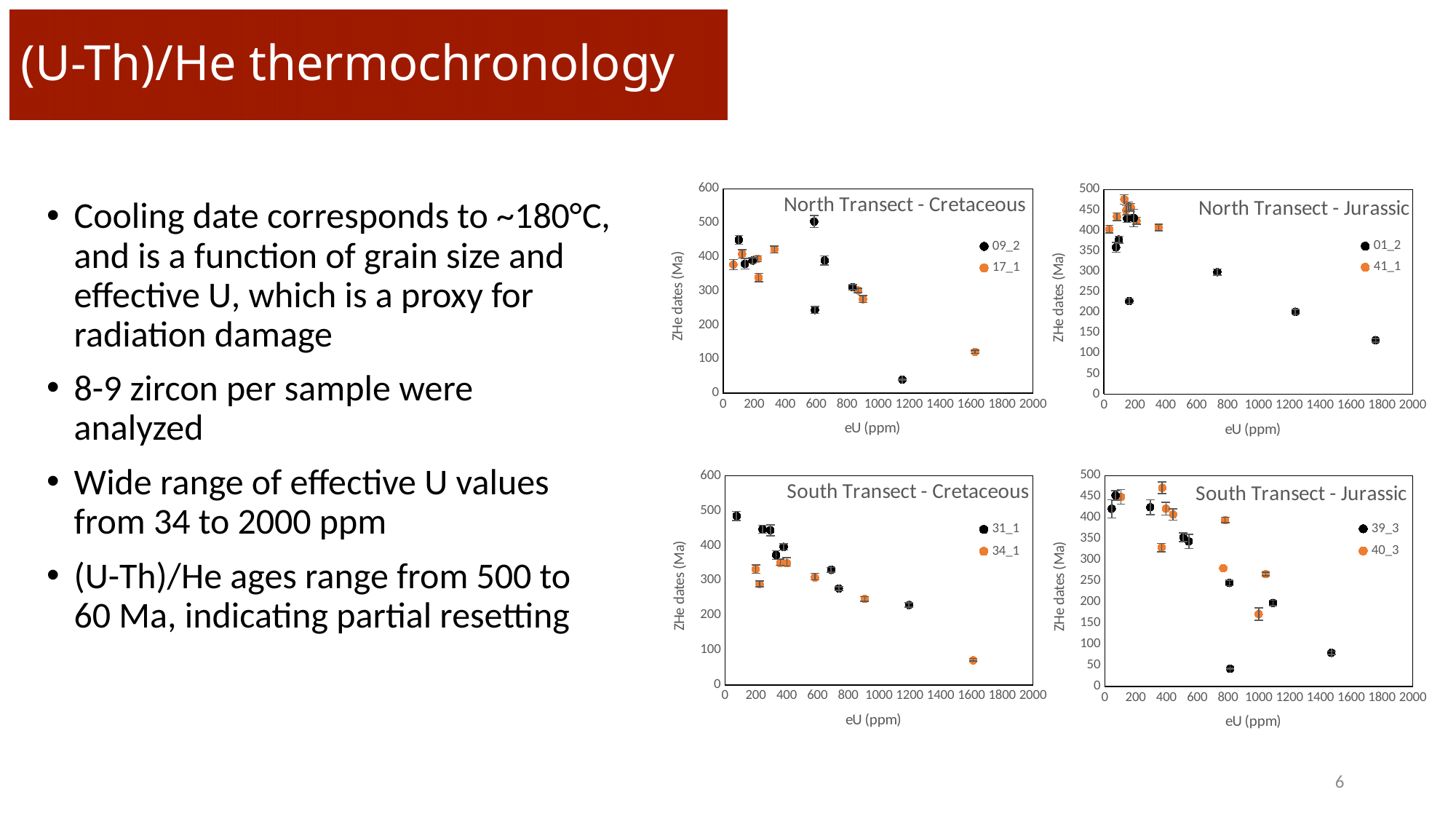
What kind of chart is the "North Transect - Cretaceous" chart? scatter chart In the "South Transect - Cretaceous" chart, do the ZHe dates generally rise or fall as eU increases? fall In the "North Transect - Jurassic" chart, is the ZHe date of the 01_2 point near 1750 ppm eU greater or less than 200? less How many charts are shown on the slide? 4 What are the two legend entries in the "North Transect - Jurassic" chart? 01_2 and 41_1 In the "North Transect - Cretaceous" chart, is the ZHe date of the 17_1 point near 1600 ppm eU greater or less than 200? less What is the x-axis title of the "South Transect - Jurassic" chart? eU (ppm) In the "South Transect - Cretaceous" chart, is the ZHe date of the 34_1 point near 1600 ppm eU greater or less than 100? less How many series does the legend of the "North Transect - Cretaceous" chart list? 2 In the "North Transect - Jurassic" chart, which 01_2 point has the higher ZHe date: the one near 750 ppm eU or the one near 1750 ppm eU? the one near 750 ppm eU In the "South Transect - Cretaceous" chart, which series contains the point with the highest ZHe date? 31_1